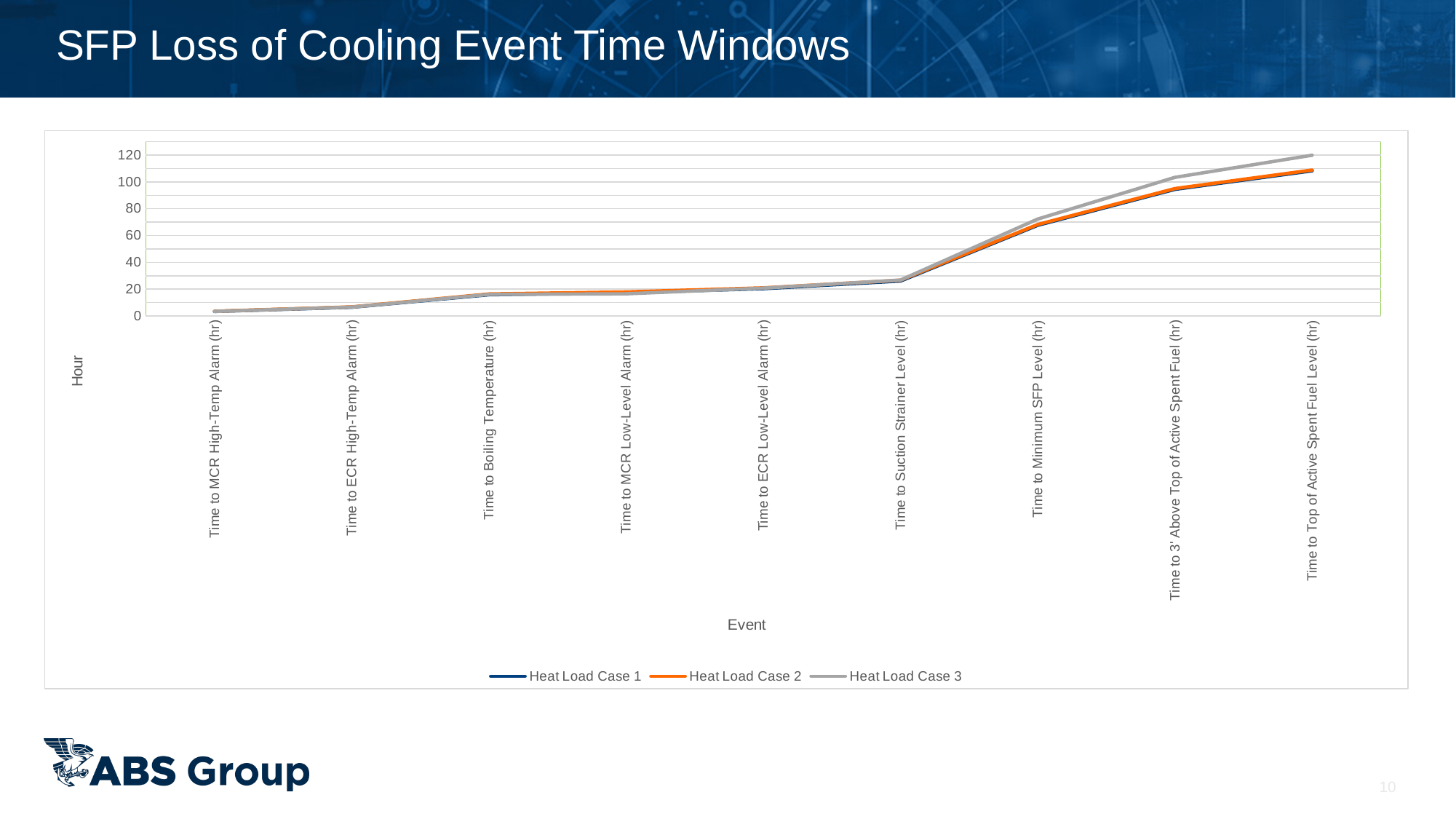
Do the values for Heat Load Case 3 rise or fall from left to right along the x axis? rise Is the value for Heat Load Case 3 at Time to Top of Active Spent Fuel Level (hr) greater or less than 100? greater How many events are plotted along the x axis? 9 Is the value for Heat Load Case 1 at Time to Suction Strainer Level (hr) greater or less than 20? greater For Heat Load Case 3, which event has the highest value? Time to Top of Active Spent Fuel Level (hr) Is the value for Heat Load Case 2 at Time to MCR High-Temp Alarm (hr) greater or less than 20? less What is the title of the vertical axis? Hour For Heat Load Case 1, which event has the lowest value? Time to MCR High-Temp Alarm (hr) What kind of chart is shown on the slide? line chart At Time to Top of Active Spent Fuel Level (hr), which is larger: Heat Load Case 3 or Heat Load Case 1? Heat Load Case 3 How many series does the legend list? 3